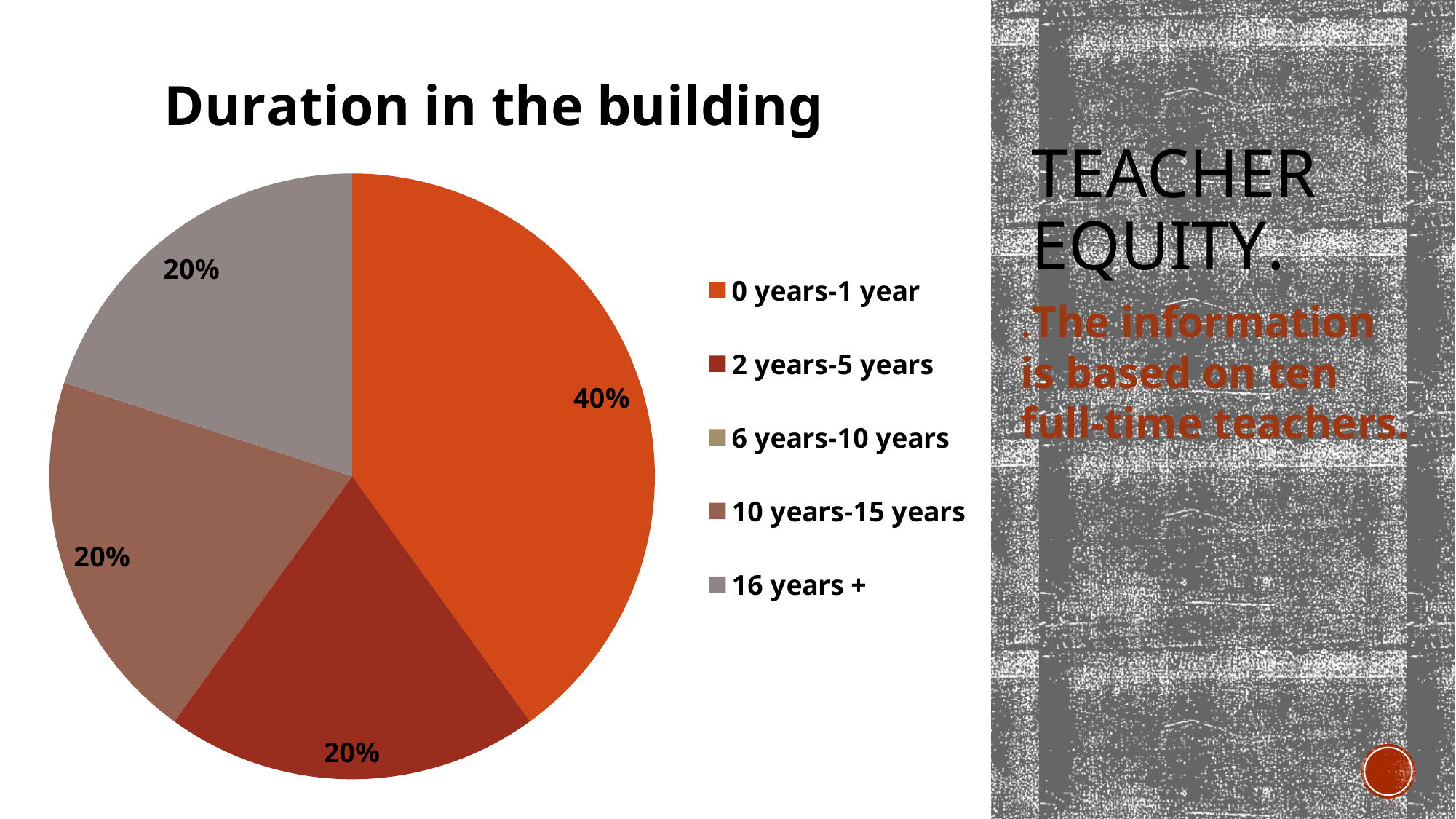
What colour is the 0 years-1 year slice? orange What percentage of the pie is the 2 years-5 years slice? 20% What percentage of the pie is the 16 years + slice? 20% What percentage of the pie is the 0 years-1 year slice? 40% How many entries does the legend list? 5 What kind of chart is shown on the slide? pie chart What is the difference between the 0 years-1 year slice and the 16 years + slice? 20 percentage points What is the combined share of the 2 years-5 years, 10 years-15 years and 16 years + slices? 60% What percentage of the pie is the 10 years-15 years slice? 20% Which is larger, the 0 years-1 year slice or the 2 years-5 years slice? 0 years-1 year Which category has the largest slice of the pie? 0 years-1 year What is the title of the chart? Duration in the building